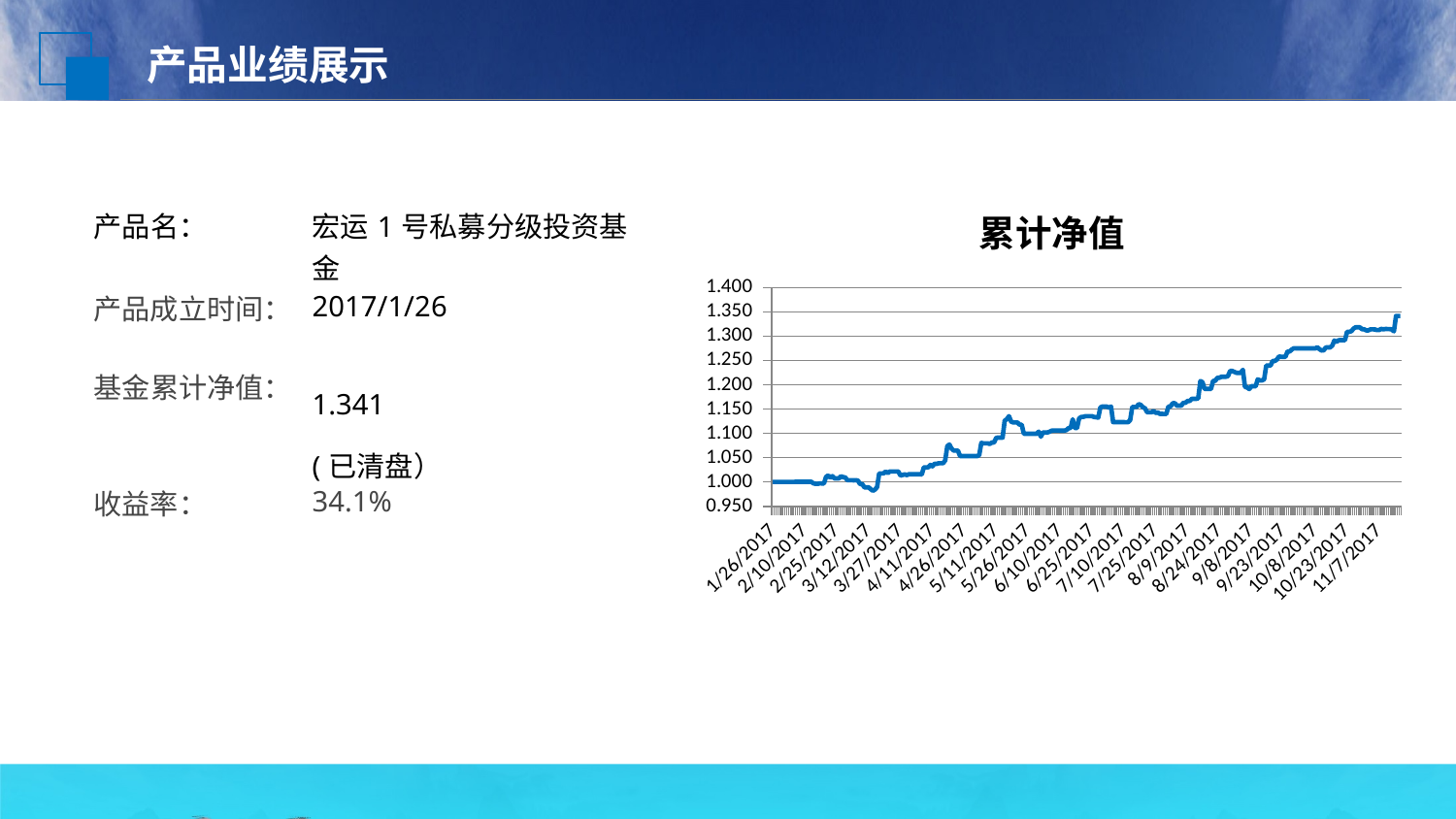
How many lines are plotted on the chart? 1 What is the first date label on the x axis? 1/26/2017 What is the highest value shown on the y axis? 1.400 What is the value at the start of the line, on 1/26/2017? 1.000 Is the value on 4/11/2017 greater or less than 1.050? less Is the value on 11/7/2017 greater or less than 1.300? greater What kind of chart is shown on the slide? line chart Is the value on 8/24/2017 greater or less than 1.150? greater Which date has the larger value, 1/26/2017 or 11/7/2017? 11/7/2017 Overall, does the plotted value rise or fall from 1/26/2017 to 11/7/2017? rise What is the title of the chart? 累计净值